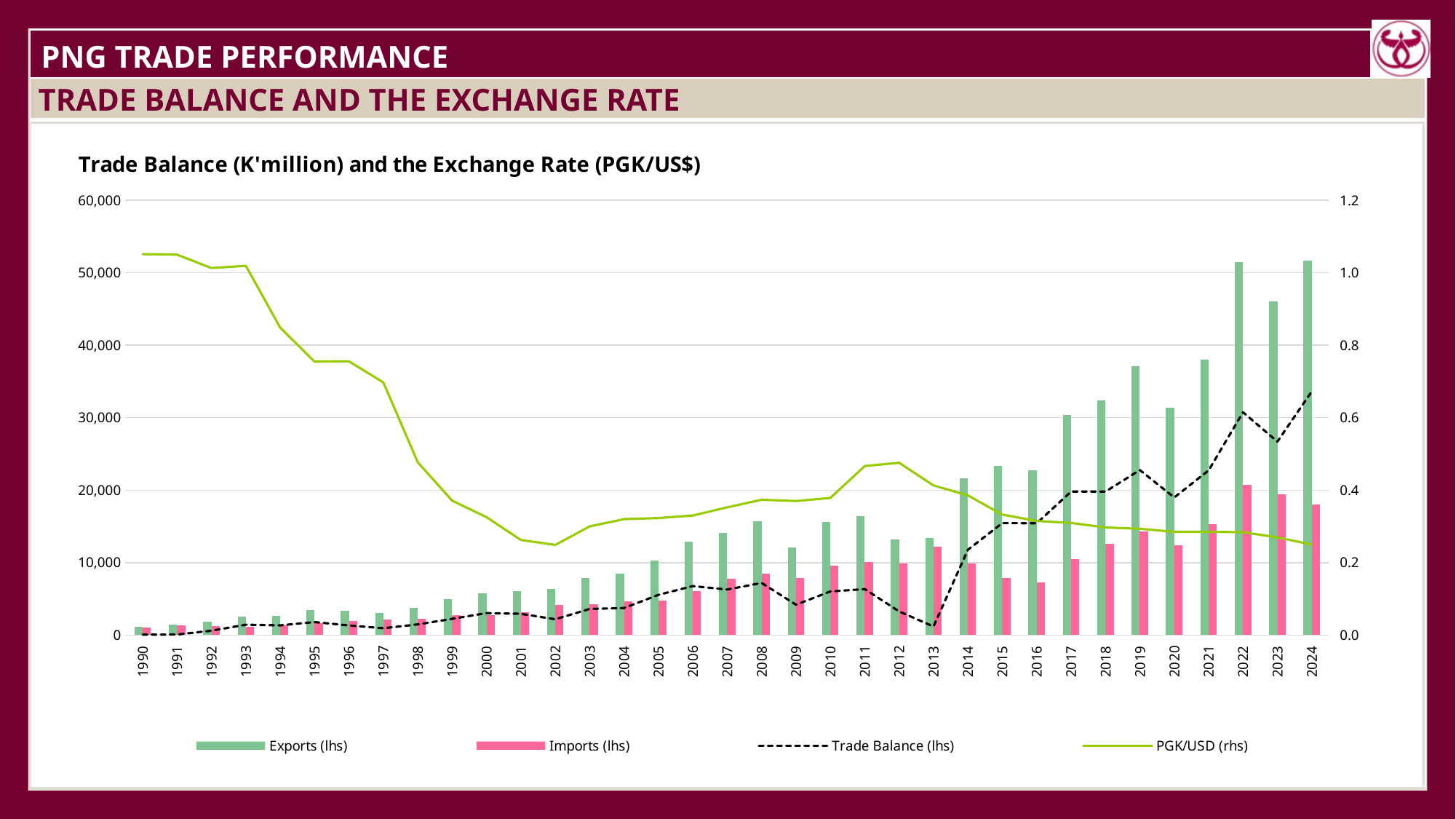
How many years are shown on the x axis? 35 Which is larger in 2024, Exports (lhs) or Imports (lhs)? Exports (lhs) Is the value for Imports (lhs) in 2024 greater or less than 20,000? less What is the title of the chart? Trade Balance (K'million) and the Exchange Rate (PGK/US$) Is the value for Exports (lhs) in 2021 greater or less than 30,000? greater What kind of chart is this? Combined bar and line chart Is the PGK/USD (rhs) value in 2024 greater or less than 0.4? less Which year has larger Exports (lhs), 2020 or 2021? 2021 How many series does the legend list? 4 Does the PGK/USD (rhs) line generally rise or fall from 1990 to 2024? fall